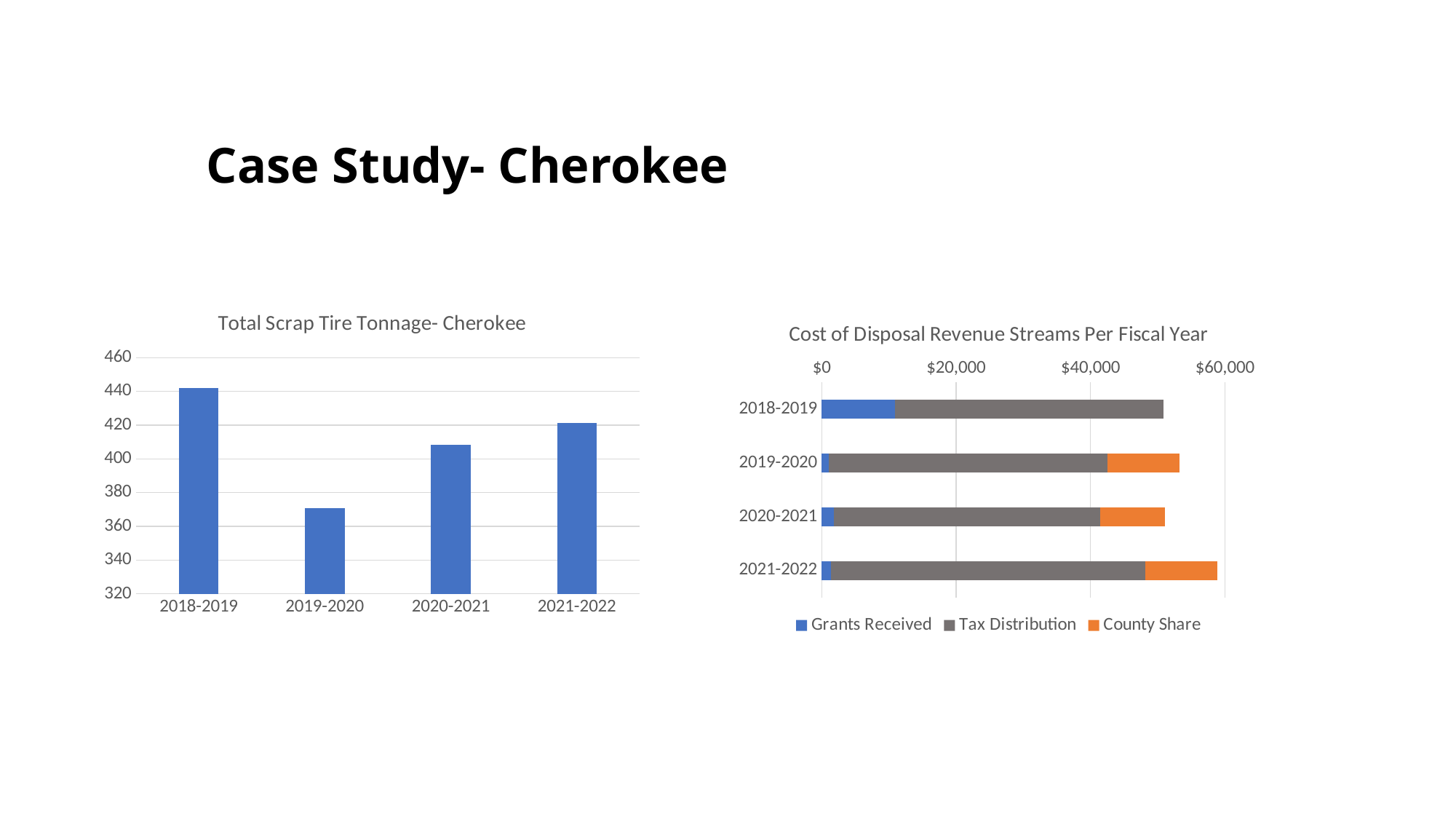
How many fiscal years are shown on the 'Total Scrap Tire Tonnage- Cherokee' chart? 4 On the 'Total Scrap Tire Tonnage- Cherokee' chart, is the value for 2021-2022 greater or less than 400? greater On the 'Total Scrap Tire Tonnage- Cherokee' chart, which fiscal year has the lowest tonnage? 2019-2020 On the 'Cost of Disposal Revenue Streams Per Fiscal Year' chart, is the total bar for 2018-2019 greater or less than $60,000? less On the 'Cost of Disposal Revenue Streams Per Fiscal Year' chart, which series is shown in orange? County Share On the 'Total Scrap Tire Tonnage- Cherokee' chart, which is larger, the value for 2020-2021 or 2021-2022? 2021-2022 What kind of chart is the 'Total Scrap Tire Tonnage- Cherokee' chart? bar chart What kind of chart is the 'Cost of Disposal Revenue Streams Per Fiscal Year' chart? stacked bar chart On the 'Total Scrap Tire Tonnage- Cherokee' chart, which fiscal year has the highest tonnage? 2018-2019 How many series does the legend of the 'Cost of Disposal Revenue Streams Per Fiscal Year' chart list? 3 On the 'Cost of Disposal Revenue Streams Per Fiscal Year' chart, which fiscal year has the largest Grants Received segment? 2018-2019 On the 'Total Scrap Tire Tonnage- Cherokee' chart, is the value for 2019-2020 greater or less than 380? less